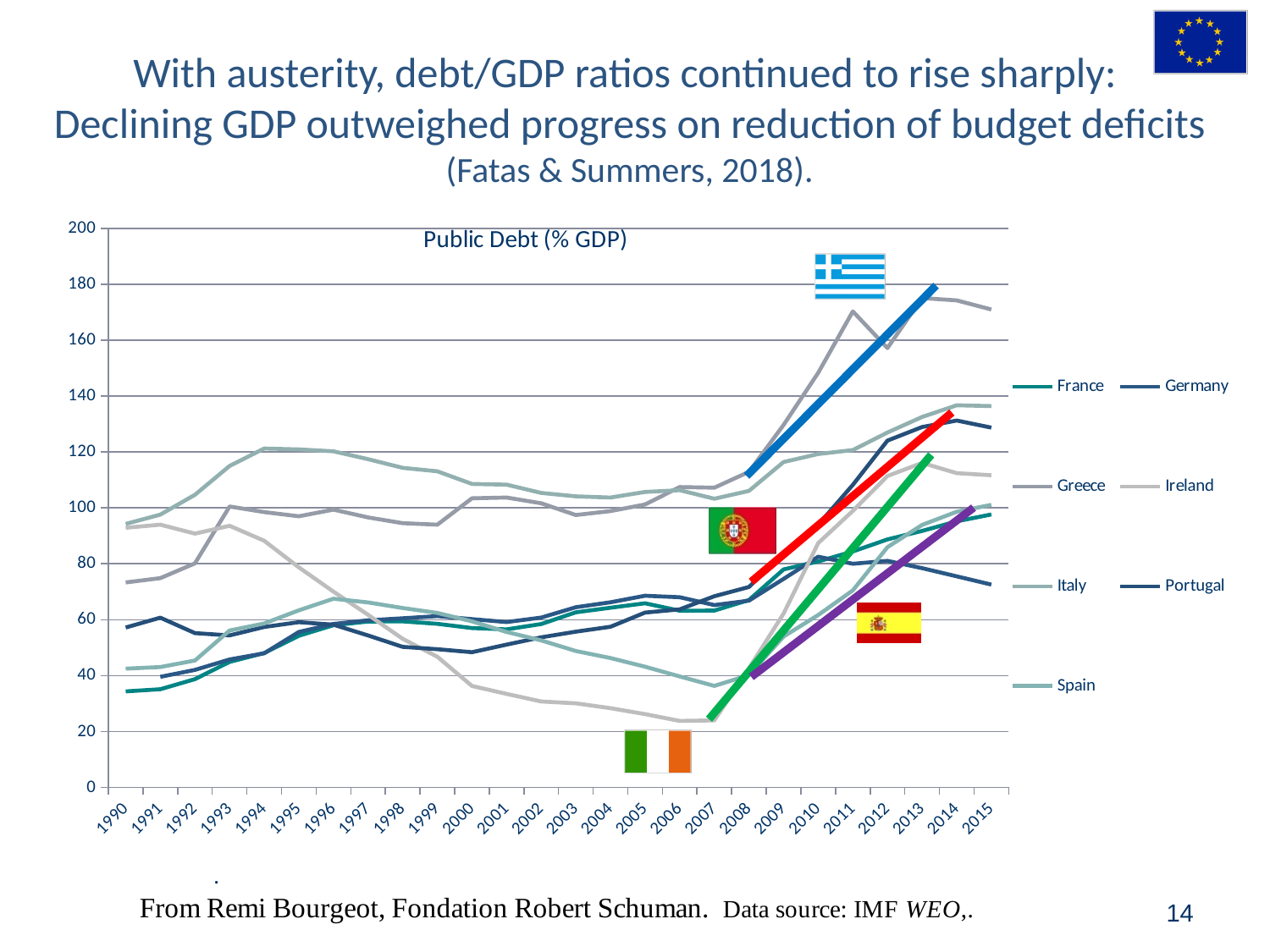
Which country has the highest public debt (% GDP) in 1990? Italy How many series does the chart legend list? 7 Which country has the lowest public debt (% GDP) in 2007? Ireland Is the value for Ireland in 2007 greater or less than 40? less Does the value for Greece rise or fall from 2008 to 2011? rise Which is larger in 2015, the value for Italy or the value for Germany? Italy How many years are shown along the x axis of the chart? 26 What is the title of the chart? Public Debt (% GDP) Which country has the highest public debt (% GDP) in 2015? Greece What kind of chart is shown on the slide? line chart Is the value for Greece in 2011 greater or less than 160? greater Which country has the lowest public debt (% GDP) in 2015? Germany